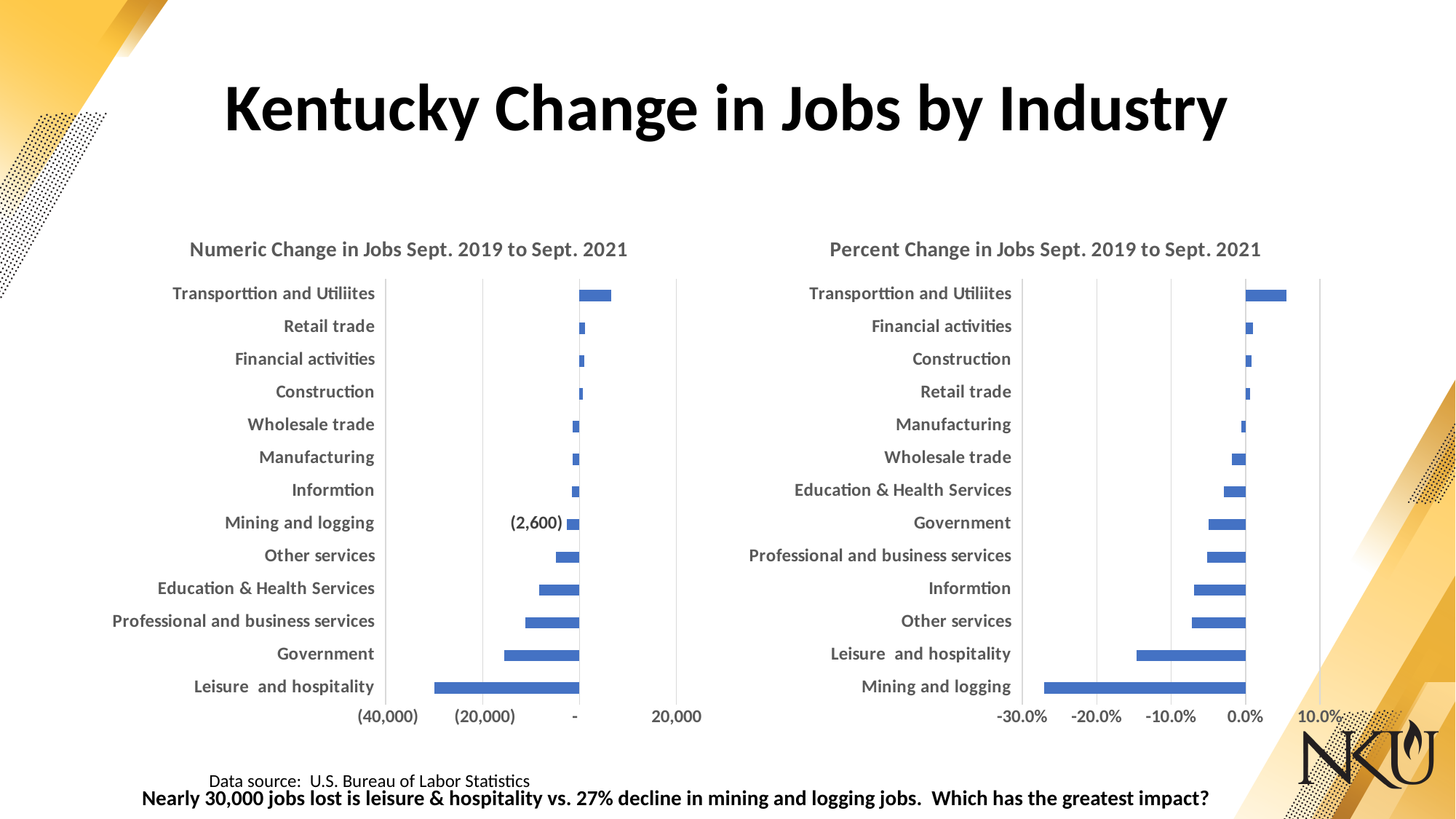
How many industries are plotted in the Numeric Change in Jobs chart? 13 In the Numeric Change in Jobs chart, which shows a larger decline in jobs, Government or Professional and business services? Government In the Percent Change in Jobs chart, is the value for Leisure and hospitality greater or less than -10.0%? less In the Percent Change in Jobs chart, which industry has the highest value? Transporttion and Utiliites What is the title of the chart on the left side of the slide? Numeric Change in Jobs Sept. 2019 to Sept. 2021 In the Numeric Change in Jobs chart, which industry has the highest value? Transporttion and Utiliites In the Percent Change in Jobs chart, is the value for Mining and logging greater or less than -20.0%? less In the Numeric Change in Jobs chart, is the value for Leisure and hospitality greater or less than (20,000)? less In the Numeric Change in Jobs chart, which industry has the largest decline in jobs? Leisure and hospitality What kind of chart is the Percent Change in Jobs chart? Bar chart In the Percent Change in Jobs chart, which industry has the lowest value? Mining and logging In the Numeric Change in Jobs chart, what is the value shown for Mining and logging? (2,600)